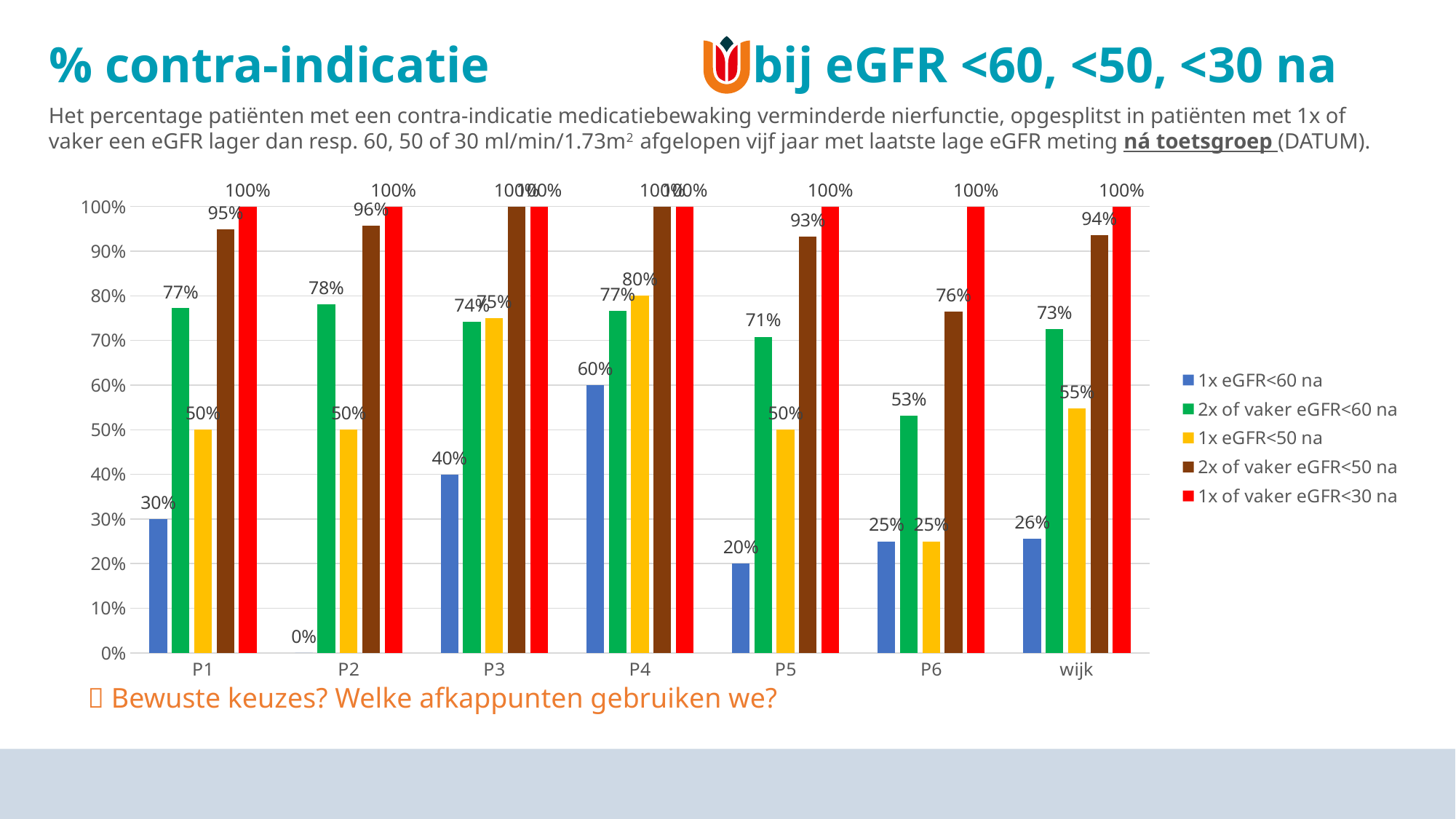
Which category has the lowest value in the '2x of vaker eGFR<60 na' series? P6 What is the value for P5 in the '2x of vaker eGFR<50 na' series? 93% What is the value for P1 in the '1x eGFR<60 na' series? 30% What is the value for P4 in the '1x eGFR<50 na' series? 80% Which is larger for P6: the '2x of vaker eGFR<60 na' value or the '2x of vaker eGFR<50 na' value? 2x of vaker eGFR<50 na What is the value for wijk in the '2x of vaker eGFR<60 na' series? 73% Which colour represents the '1x of vaker eGFR<30 na' series? Red How many categories are shown on the x axis? 7 What kind of chart is shown on the slide? Bar chart Which category has the highest value in the '1x eGFR<60 na' series? P4 What is the difference between the '2x of vaker eGFR<60 na' value and the '1x eGFR<60 na' value for P2? 78% How many series does the legend list? 5